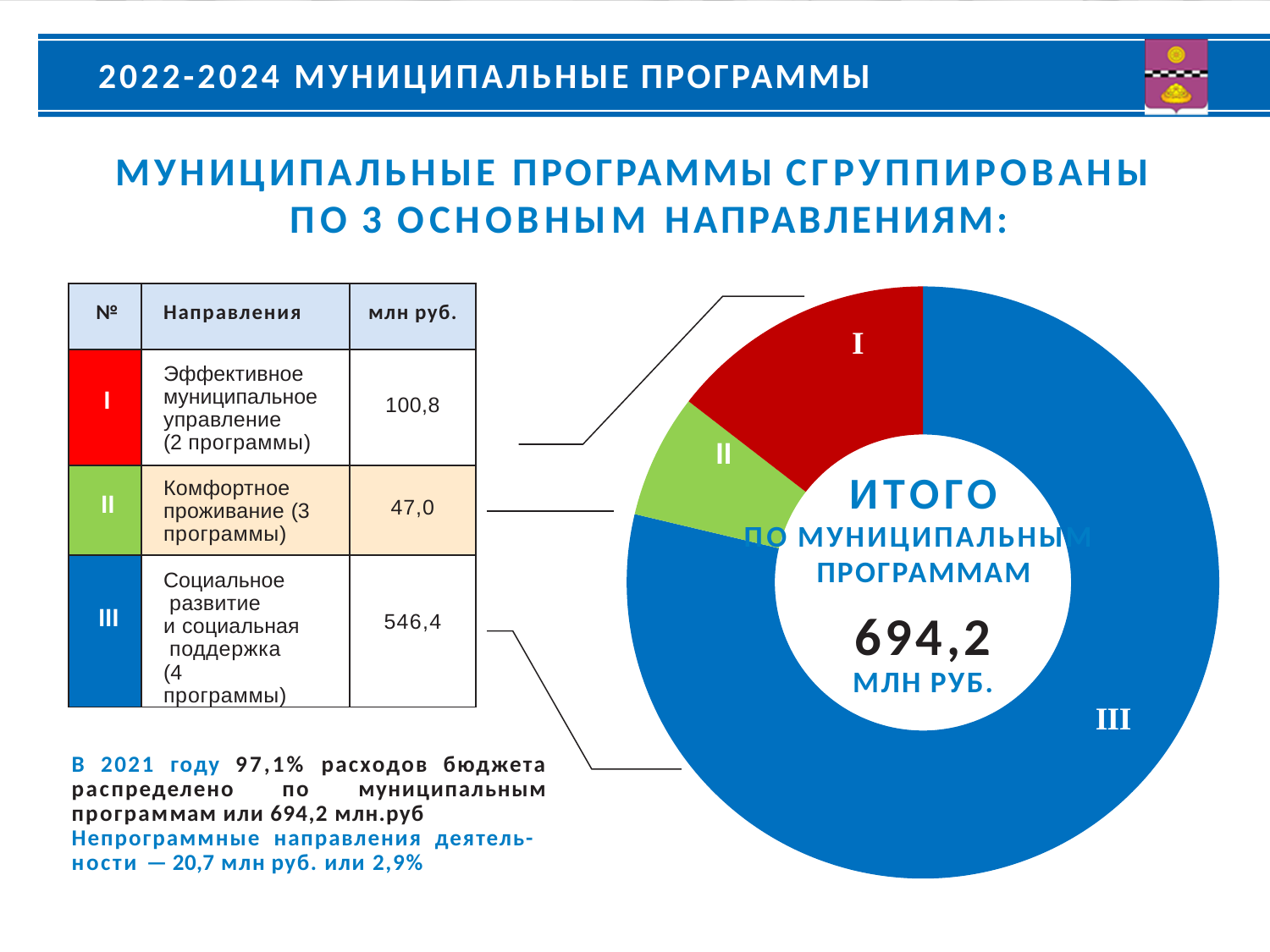
What is the total shown in the centre of the doughnut chart? 694,2 млн руб. How many segments does the doughnut chart have? 3 What is the value (млн руб.) for segment I, Эффективное муниципальное управление? 100,8 Which is larger, the value for segment I or segment II? Segment I What colour is segment III in the doughnut chart? Blue Which segment of the doughnut chart is the largest? III Which segment of the doughnut chart is the smallest? II What is the value (млн руб.) for segment III, Социальное развитие и социальная поддержка? 546,4 What kind of chart is shown on the slide? Doughnut (pie) chart What is the difference between the values for segment III and segment I? 445,6 What is the value (млн руб.) for segment II, Комфортное проживание? 47,0 What colour is segment I in the doughnut chart? Red